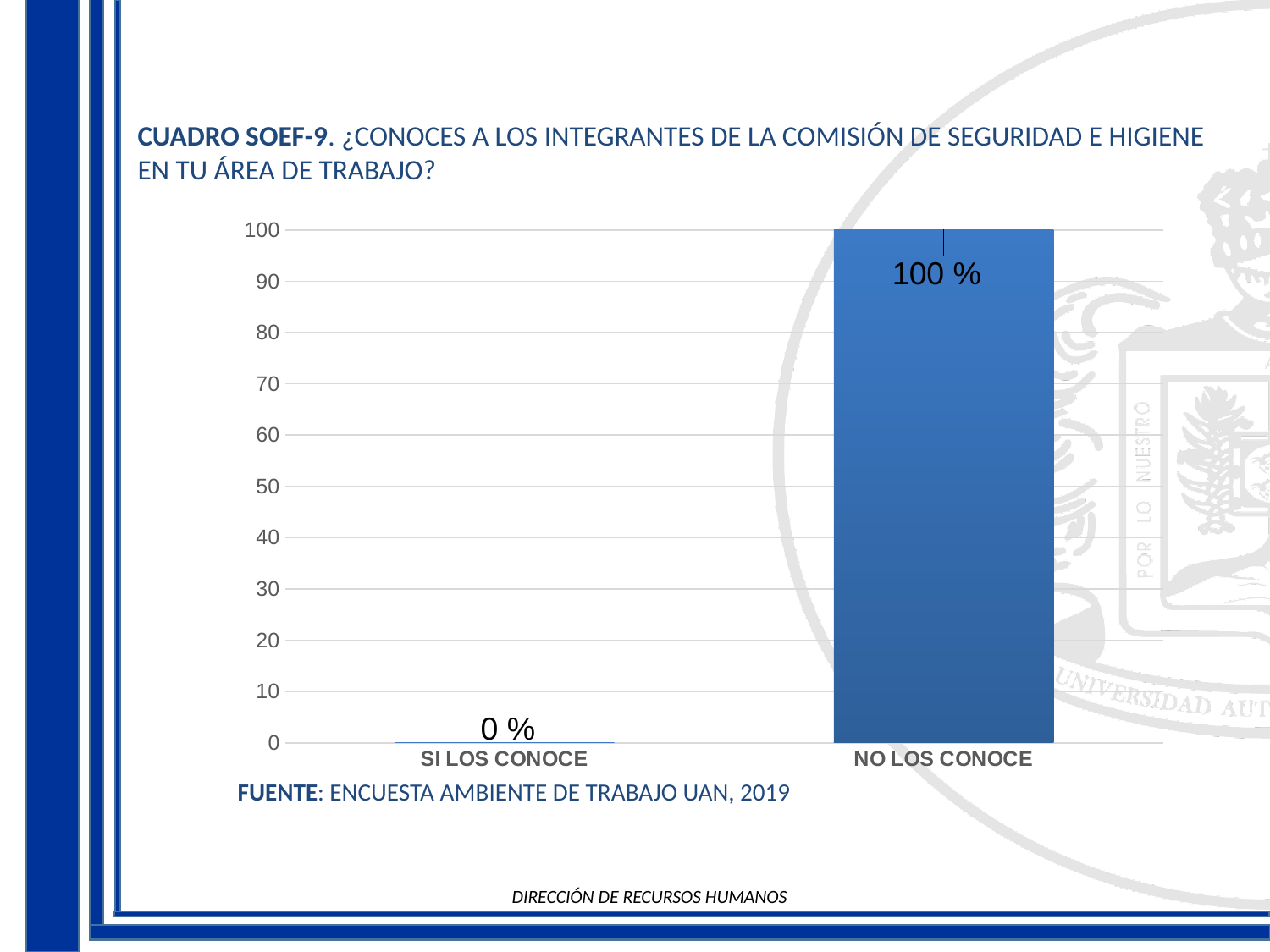
Is the value for NO LOS CONOCE greater or less than 50? greater What kind of chart is shown on the slide? bar chart Which is larger, the value for SI LOS CONOCE or NO LOS CONOCE? NO LOS CONOCE Which category has the highest value? NO LOS CONOCE What is the maximum value shown on the y axis? 100 What is the value for SI LOS CONOCE? 0 % Which category has the lowest value? SI LOS CONOCE How many categories are shown on the x axis? 2 What is the value for NO LOS CONOCE? 100 % What source is cited below the chart? ENCUESTA AMBIENTE DE TRABAJO UAN, 2019 What is the difference between the values for NO LOS CONOCE and SI LOS CONOCE? 100 %